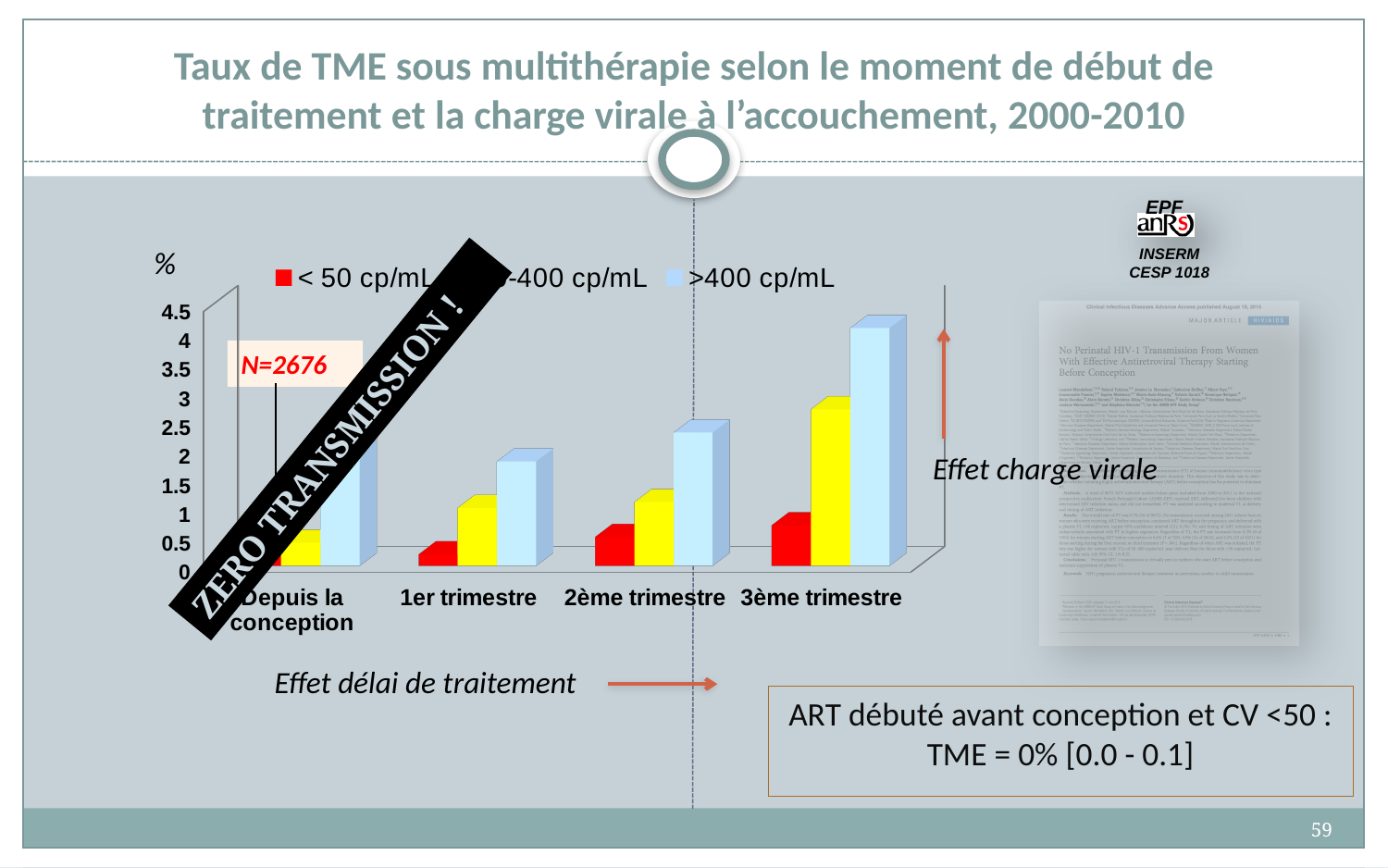
What kind of chart is shown on the slide? bar chart Which is larger: the >400 cp/mL value at 3ème trimestre or the >400 cp/mL value at 1er trimestre? 3ème trimestre Is the value for >400 cp/mL at 3ème trimestre greater or less than 3.5? greater What sample size (N) is annotated on the chart? N=2676 What unit is indicated on the y axis of the chart? % How many categories (treatment start periods) are shown on the x axis of the chart? 4 Do the < 50 cp/mL values rise or fall from Depuis la conception to 3ème trimestre? rise For which category is the < 50 cp/mL bar the lowest? Depuis la conception For which category is the >400 cp/mL bar the highest? 3ème trimestre How many series does the chart legend list? 3 Is the value for < 50 cp/mL at 1er trimestre greater or less than 0.5? less Is the value for >400 cp/mL at 2ème trimestre greater or less than 2? greater